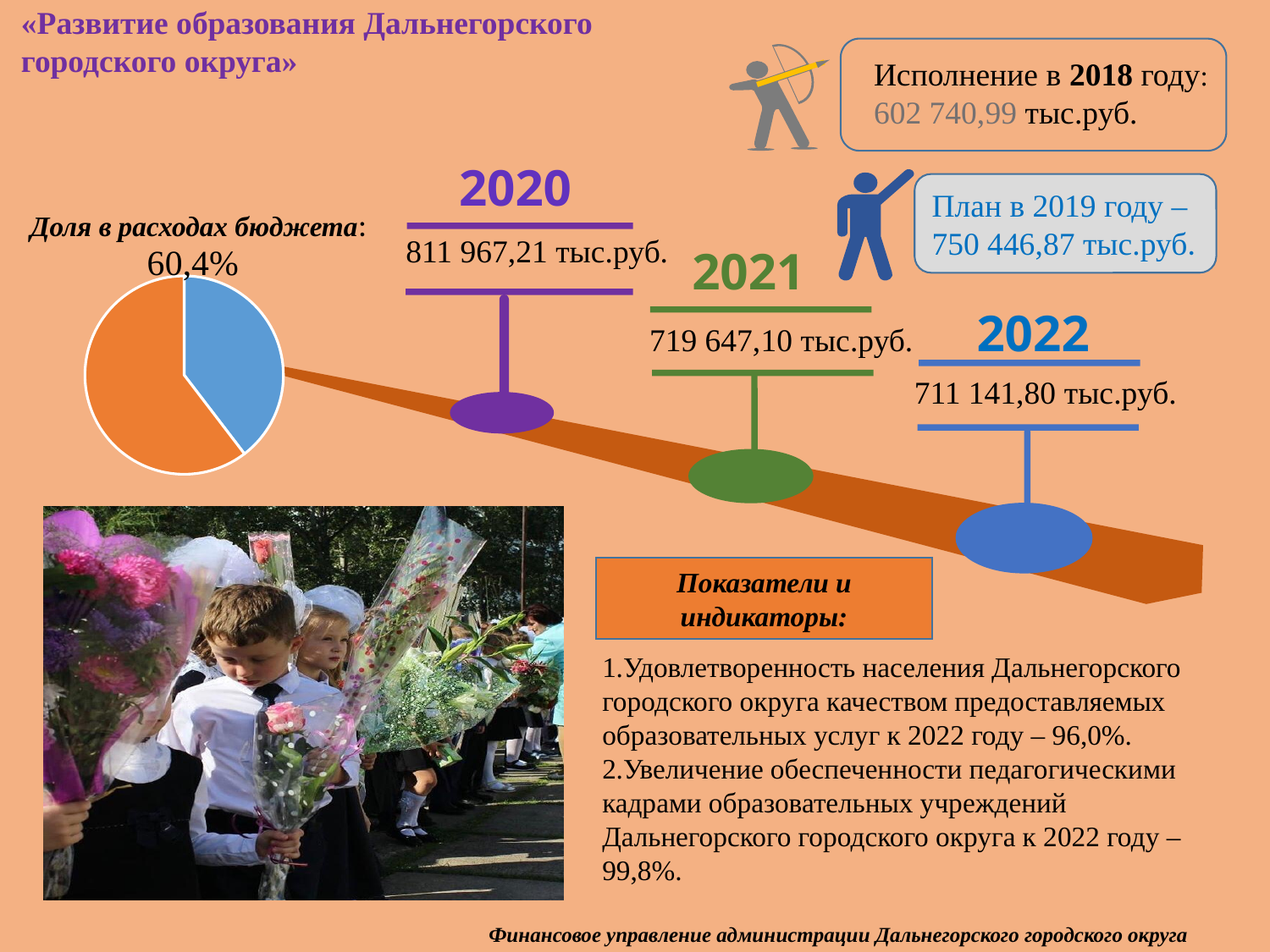
What share value is printed above the pie chart? 60,4% What kind of chart is shown on the left of the slide under the heading «Доля в расходах бюджета»? pie chart Which slice of the pie chart is larger, the orange one or the blue one? orange What two colours are used for the slices of the pie chart? orange and blue What is the heading printed above the pie chart? Доля в расходах бюджета Is the orange slice of the pie chart greater or less than half of the pie? greater How many slices does the pie chart have? 2 Is the blue slice of the pie chart greater or less than half of the pie? less Which slice of the pie chart is the smallest? the blue slice